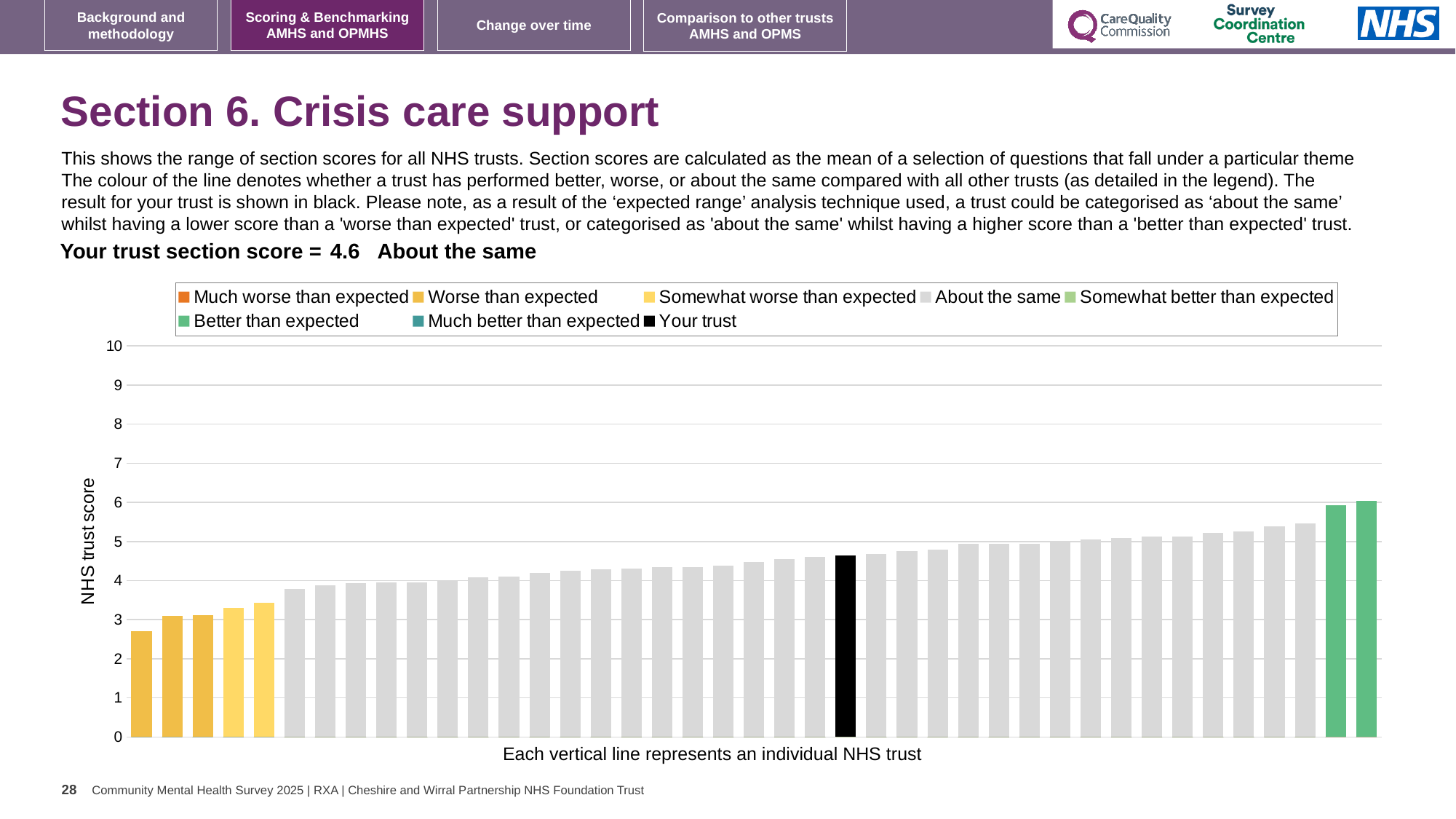
Is the value of the black bar (your trust) greater or less than 5? less Is the value of the black bar (your trust) greater or less than 4? greater Do the bar values rise or fall from left to right along the x axis? rise What is the section score for your trust shown on the slide? 4.6 Is the value of the rightmost bar greater or less than 5? greater What does each vertical line on the chart represent, according to the x-axis label? an individual NHS trust What is the label of the y axis? NHS trust score How many bars are coloured green (better than expected) on the chart? 2 What kind of chart is shown on the slide? bar chart How is your trust categorised compared with other trusts, according to the text above the chart? About the same How many entries does the chart legend list? 8